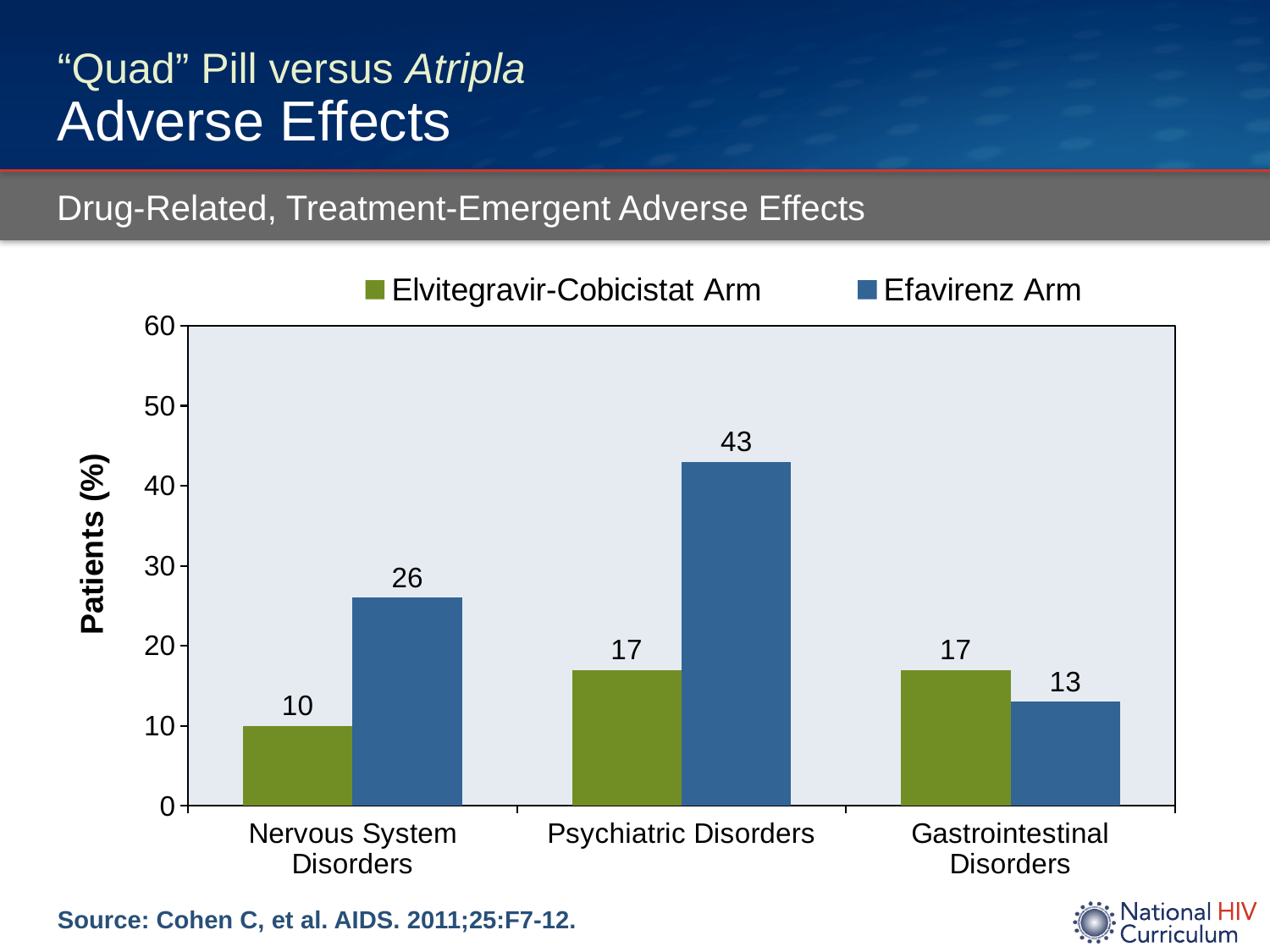
How many series does the legend list? 2 What percentage of patients in the Elvitegravir-Cobicistat Arm had Nervous System Disorders? 10 What kind of chart is shown on the slide? Bar chart Which category has the lowest value for the Elvitegravir-Cobicistat Arm? Nervous System Disorders Which category has the highest value for the Efavirenz Arm? Psychiatric Disorders For Gastrointestinal Disorders, which arm has the larger value? Elvitegravir-Cobicistat Arm Is the value for the Efavirenz Arm for Psychiatric Disorders greater or less than 40? greater What percentage of patients in the Efavirenz Arm had Psychiatric Disorders? 43 What is the difference between the Efavirenz Arm and the Elvitegravir-Cobicistat Arm for Psychiatric Disorders? 26 What is the difference between the Efavirenz Arm and the Elvitegravir-Cobicistat Arm for Nervous System Disorders? 16 How many adverse effect categories are shown on the x axis? 3 What is the value for Gastrointestinal Disorders in the Efavirenz Arm? 13